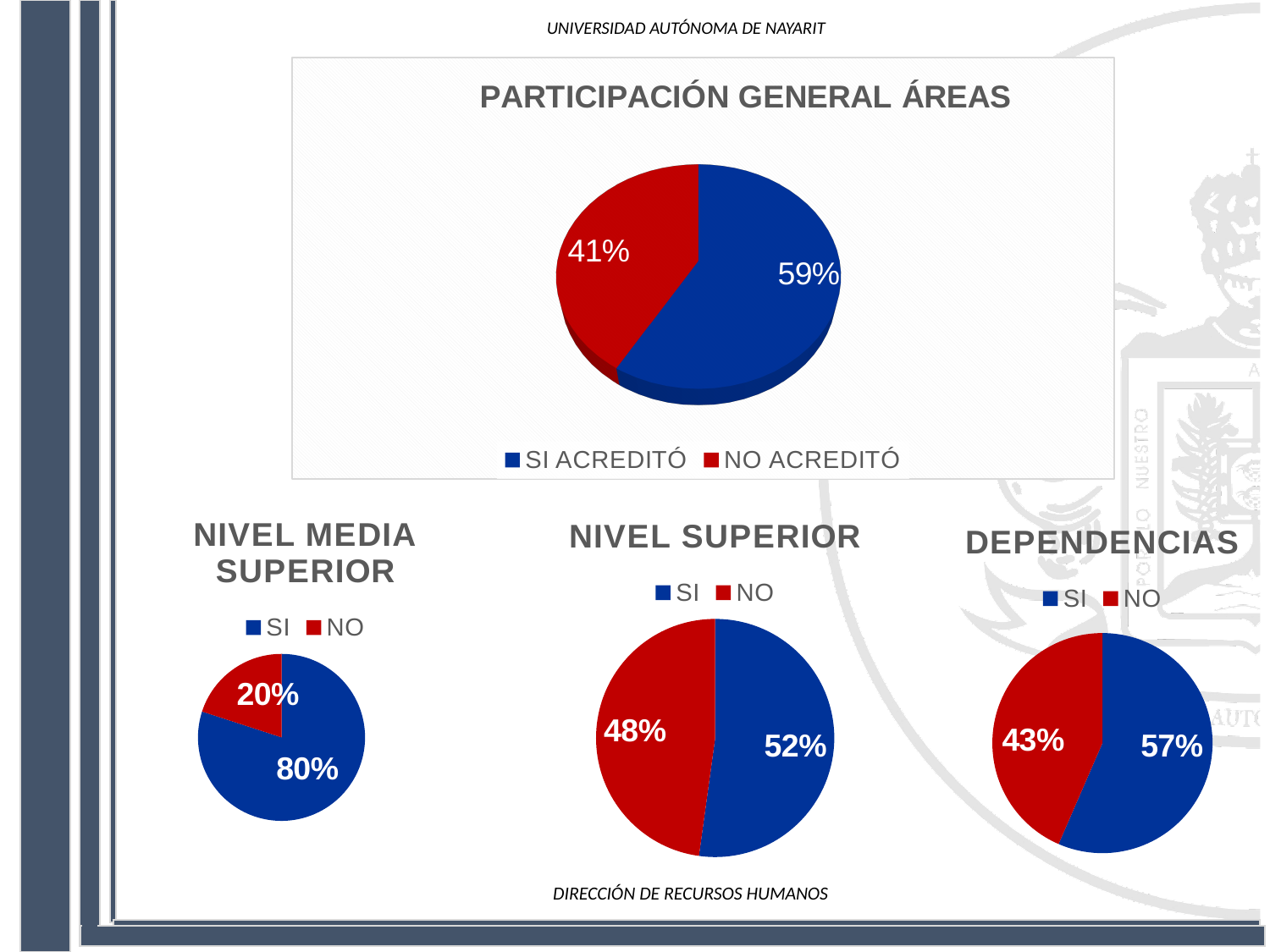
In the DEPENDENCIAS chart, what is the difference between the SI and NO percentages? 14% In the NIVEL MEDIA SUPERIOR chart, what is the difference between the SI and NO percentages? 60% In the NIVEL MEDIA SUPERIOR chart, what percentage is shown for NO? 20% In the PARTICIPACIÓN GENERAL ÁREAS chart, what percentage is shown for NO ACREDITÓ? 41% What kind of chart is the PARTICIPACIÓN GENERAL ÁREAS chart? Pie chart In the PARTICIPACIÓN GENERAL ÁREAS chart, what percentage is shown for SI ACREDITÓ? 59% In the DEPENDENCIAS chart, what percentage is shown for SI? 57% In the NIVEL MEDIA SUPERIOR chart, what percentage is shown for SI? 80% How many slices does the PARTICIPACIÓN GENERAL ÁREAS pie chart have? 2 In the NIVEL SUPERIOR chart, which slice is larger, SI or NO? SI In the NIVEL SUPERIOR chart, what percentage is shown for NO? 48% In the PARTICIPACIÓN GENERAL ÁREAS chart, what colour represents NO ACREDITÓ? Red